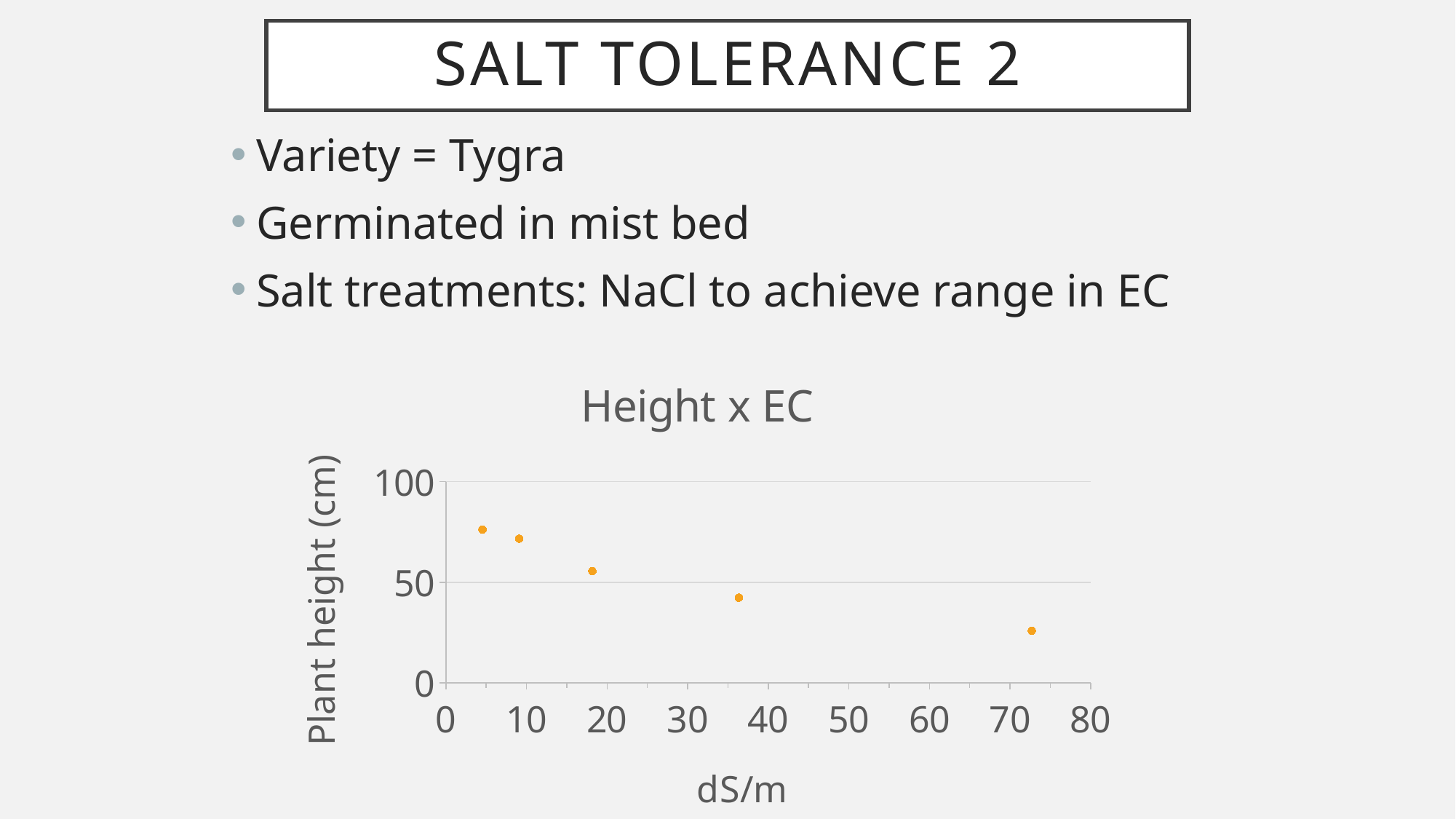
What is the title of the chart? Height x EC Which point has the greatest plant height: the one at the lowest EC or the one at the highest EC? the one at the lowest EC What is the label of the y axis? Plant height (cm) Is the plant height of the point near 9 dS/m greater or less than 100? less Is the plant height of the point at the highest EC (around 73 dS/m) greater or less than 50? less As EC (dS/m) increases along the x axis, does plant height rise or fall? fall Is the plant height of the point at the lowest EC (around 5 dS/m) greater or less than 50? greater What kind of chart is shown on the slide? scatter plot How many data points are plotted in the chart? 5 Which point has the lowest plant height? the point at the highest EC (around 73 dS/m) Which point has the highest plant height? the point at the lowest EC (around 5 dS/m)